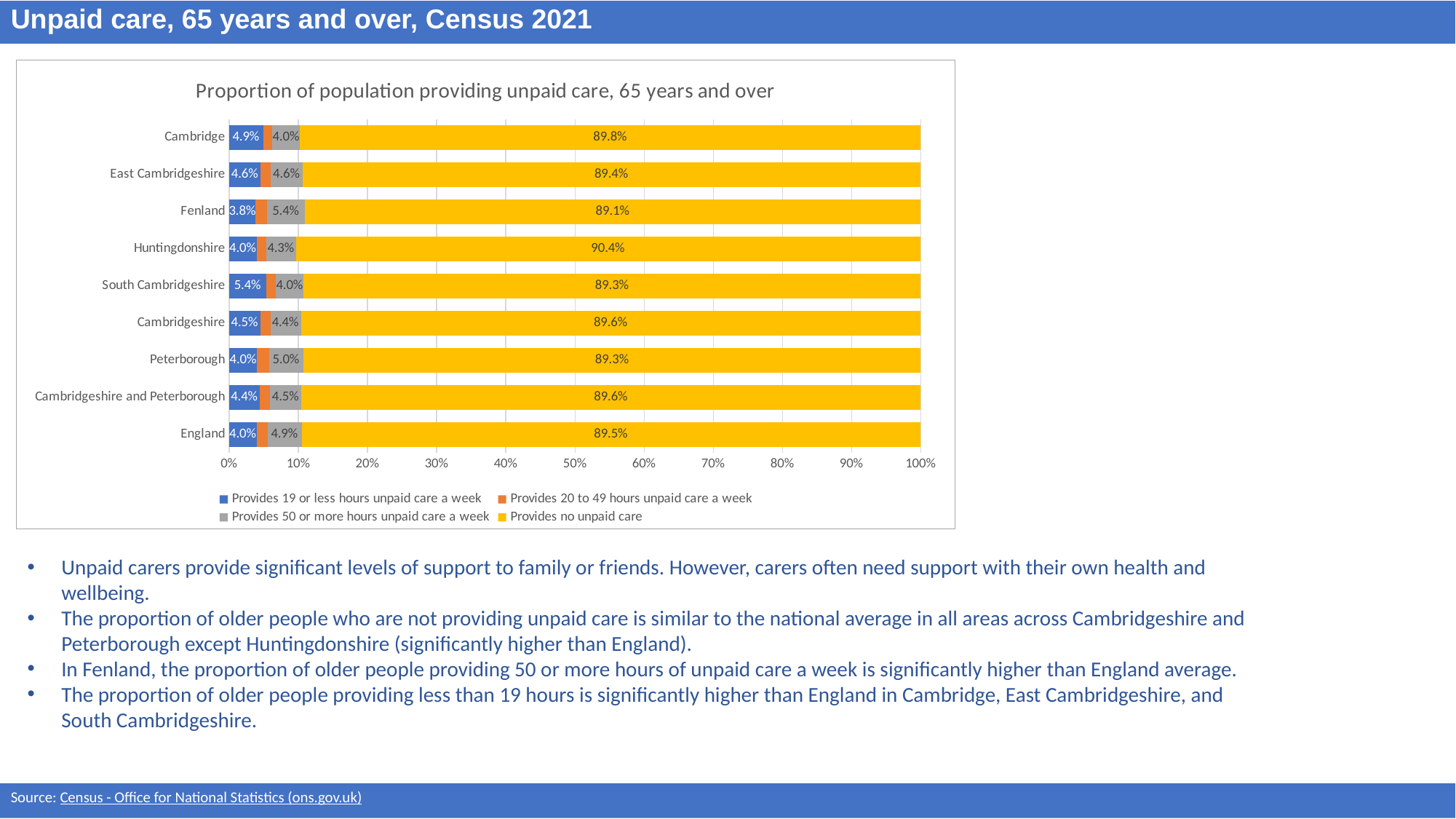
How many areas are listed on the chart? 9 What is the title of the chart? Proportion of population providing unpaid care, 65 years and over What proportion of people aged 65 and over in Fenland provide 50 or more hours of unpaid care a week? 5.4% Which area has the lowest proportion providing no unpaid care? Fenland How many series does the legend list? 4 Which has a higher proportion providing 50 or more hours of unpaid care a week, Peterborough or Cambridge? Peterborough What type of chart is shown on the slide? Stacked bar chart Which area has the lowest proportion providing 19 or less hours of unpaid care a week? Fenland What proportion of people aged 65 and over in South Cambridgeshire provide 19 or less hours of unpaid care a week? 5.4% What is the difference in percentage points between the proportion providing no unpaid care in Huntingdonshire and in Fenland? 1.3 percentage points What proportion of people aged 65 and over in Huntingdonshire provide no unpaid care? 90.4% Which area has the highest proportion providing no unpaid care? Huntingdonshire